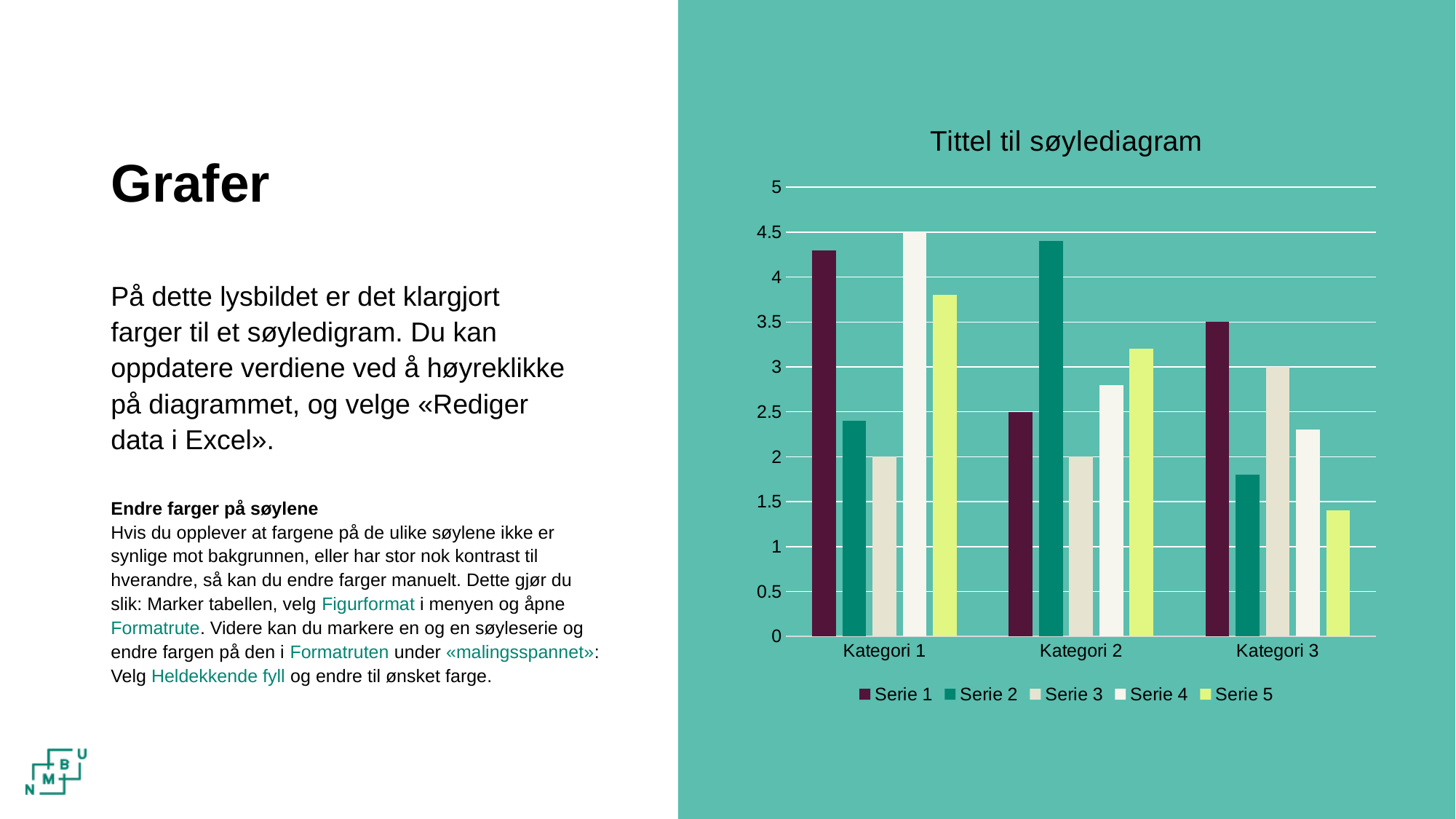
How many series does the legend list? 5 Is the value for Serie 1 in Kategori 1 greater or less than 4? greater Is the value for Serie 2 in Kategori 3 greater or less than 2? less How many categories are shown on the x axis? 3 What is the value of Serie 4 for Kategori 1? 4.5 Which series has the lowest value in Kategori 3? Serie 5 What type of chart is shown on the slide? Bar chart Which series has the highest value in Kategori 2? Serie 2 What is the title of the chart? Tittel til søylediagram What is the value of Serie 3 for Kategori 3? 3 Which is larger in Kategori 3: Serie 1 or Serie 3? Serie 1 What is the value of Serie 1 for Kategori 2? 2.5